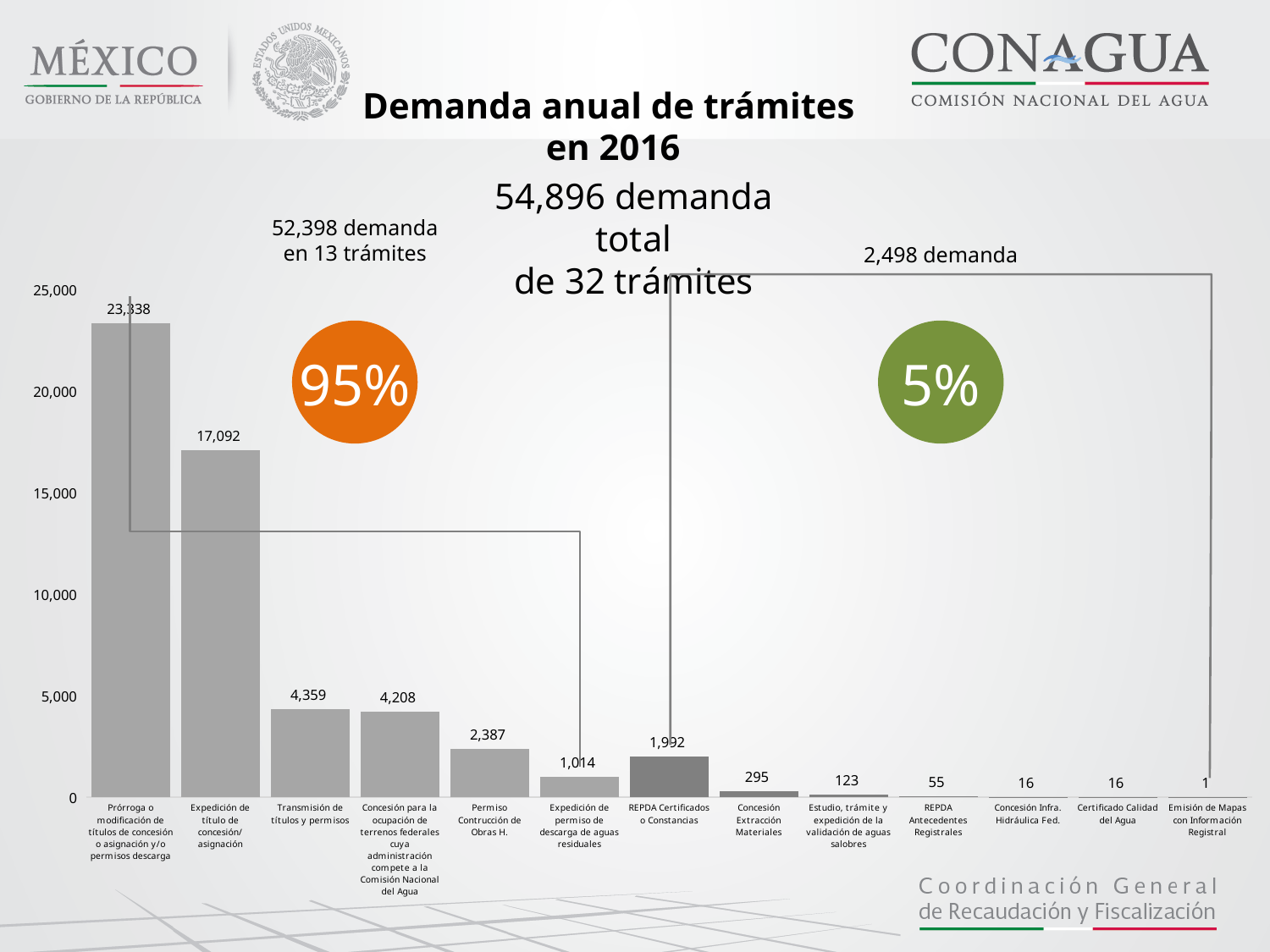
What is the value for Concesión Extracción Materiales? 295 Which category has the highest value? Prórroga o modificación de títulos de concesión o asignación y/o permisos descarga How many categories are shown on the x axis? 13 What is the difference between the values for Prórroga o modificación de títulos de concesión o asignación y/o permisos descarga and Expedición de título de concesión/asignación? 6,246 What is the value for Expedición de título de concesión/asignación? 17,092 What is the value for Transmisión de títulos y permisos? 4,359 Is the value for Expedición de título de concesión/asignación greater or less than 15,000? greater What is the value for REPDA Certificados o Constancias? 1,992 Which category has the lowest value? Emisión de Mapas con Información Registral What is the title of the chart? Demanda anual de trámites en 2016 What kind of chart is shown on the slide? bar chart Which is larger, the value for Permiso Contrucción de Obras H. or the value for REPDA Certificados o Constancias? Permiso Contrucción de Obras H.